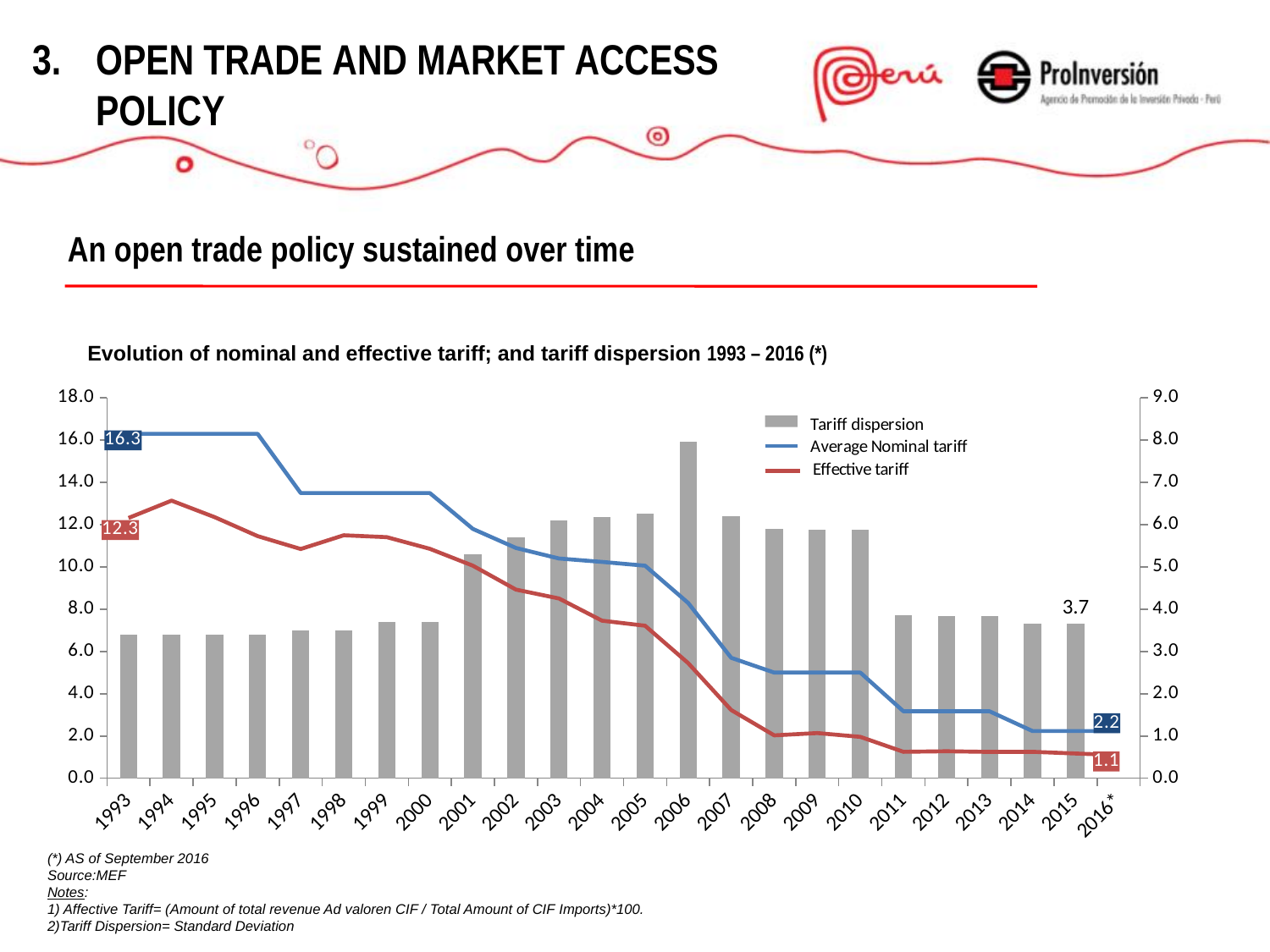
What is the difference between the Average Nominal tariff and the Effective tariff in 1993? 4.0 What is the Effective tariff value labelled for 2016*? 1.1 Is the Tariff dispersion value for 2006 greater or less than 7.0 on the right-hand axis? greater How many years are shown on the x axis of the chart? 24 What is the Average Nominal tariff value labelled for 1993? 16.3 What kind of chart is shown on the slide? A combined bar and line chart Does the Average Nominal tariff line rise or fall from 1993 to 2016*? Fall What is the Average Nominal tariff value labelled for 2016*? 2.2 In which year is the Tariff dispersion bar the highest? 2006 What is the Effective tariff value labelled for 1993? 12.3 By how much did the Average Nominal tariff fall from 1993 to 2016*? 14.1 How many series does the chart legend list? 3